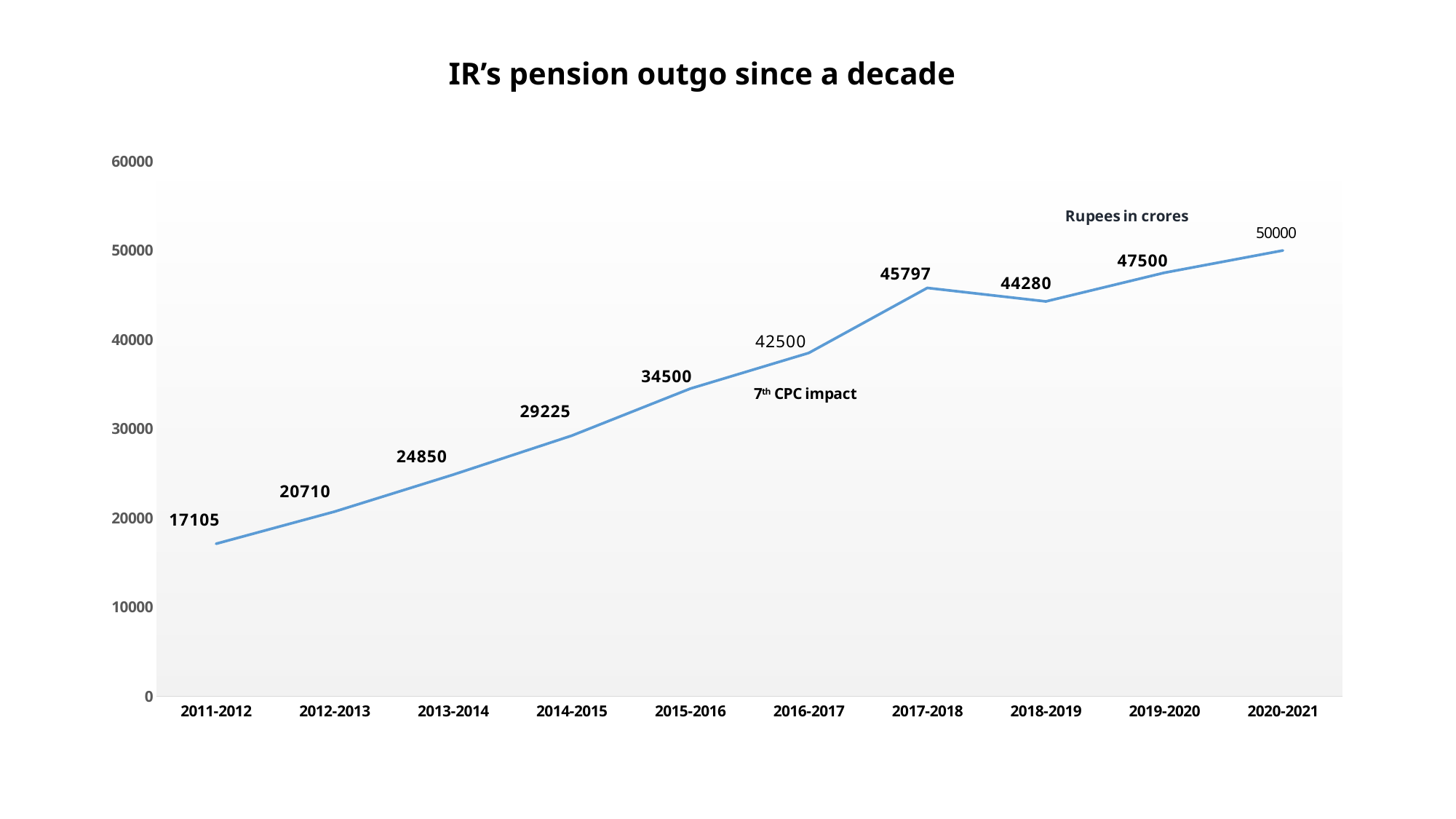
What is the pension outgo for 2020-2021? 50000 What is the title of the chart? IR's pension outgo since a decade What is the difference between the pension outgo in 2019-2020 and 2018-2019? 3220 Does the pension outgo generally rise or fall from 2011-2012 to 2020-2021? rise Which year has the highest pension outgo? 2020-2021 What is the pension outgo for 2011-2012? 17105 Which year has the lowest pension outgo? 2011-2012 Which is larger, the pension outgo in 2017-2018 or in 2018-2019? 2017-2018 What type of chart is shown on the slide? line chart What is the pension outgo for 2017-2018? 45797 How many years are plotted on the x axis? 10 What is the pension outgo for 2014-2015? 29225